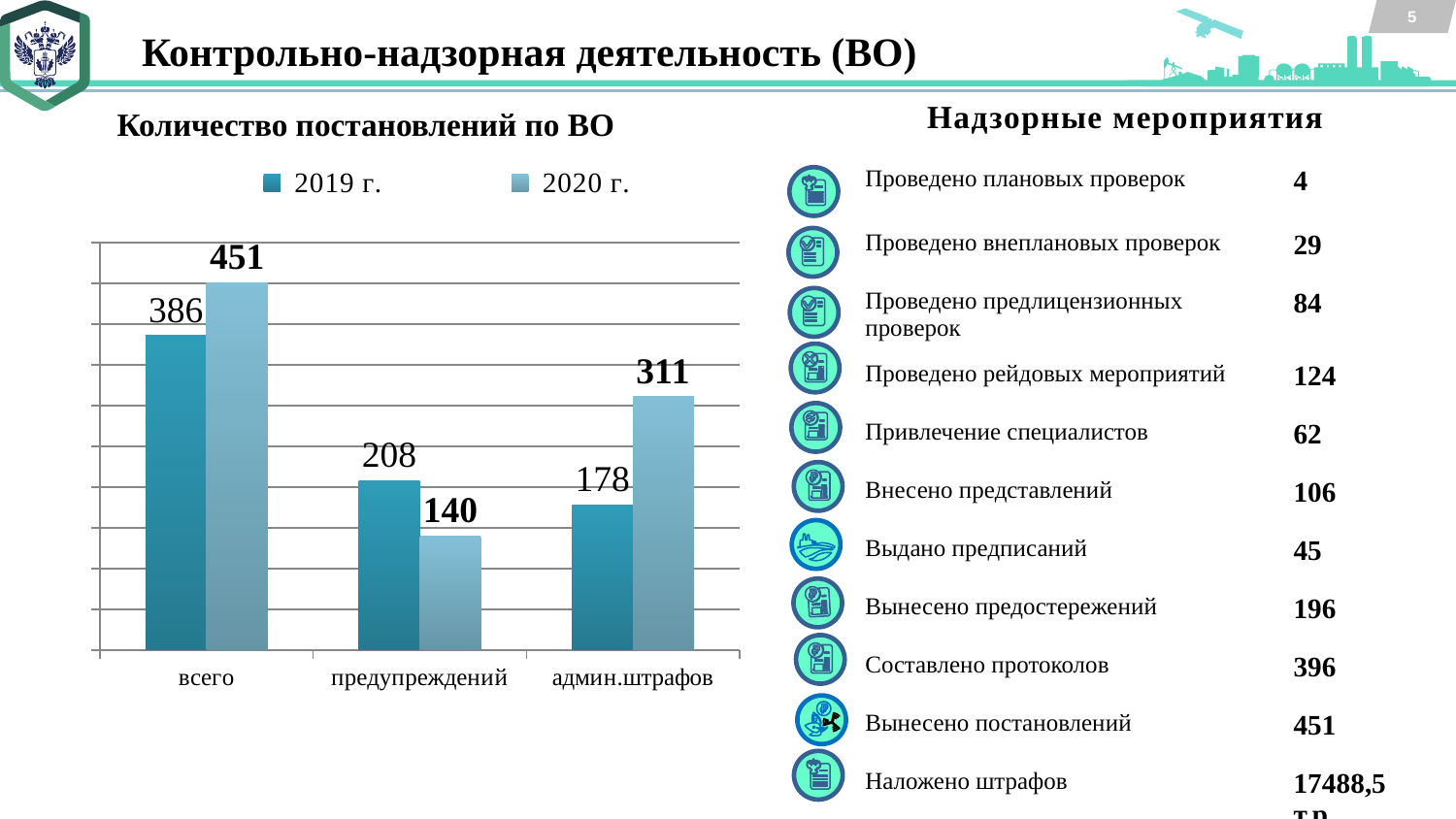
What is the value for 2019 г. in the category всего? 386 What is the value for 2019 г. in the category предупреждений? 208 What type of chart is shown on the slide? bar chart What is the difference between the 2019 г. and 2020 г. values for предупреждений? 68 What is the value for 2020 г. in the category всего? 451 Which is larger for админ.штрафов: the 2019 г. value or the 2020 г. value? 2020 г. Which category has the lowest value for 2020 г.? предупреждений How many series does the chart legend list? 2 What is the difference between the 2020 г. and 2019 г. values for всего? 65 What is the value for 2020 г. in the category админ.штрафов? 311 How many categories are shown on the x axis of the chart? 3 Which category has the highest value for 2019 г.? всего